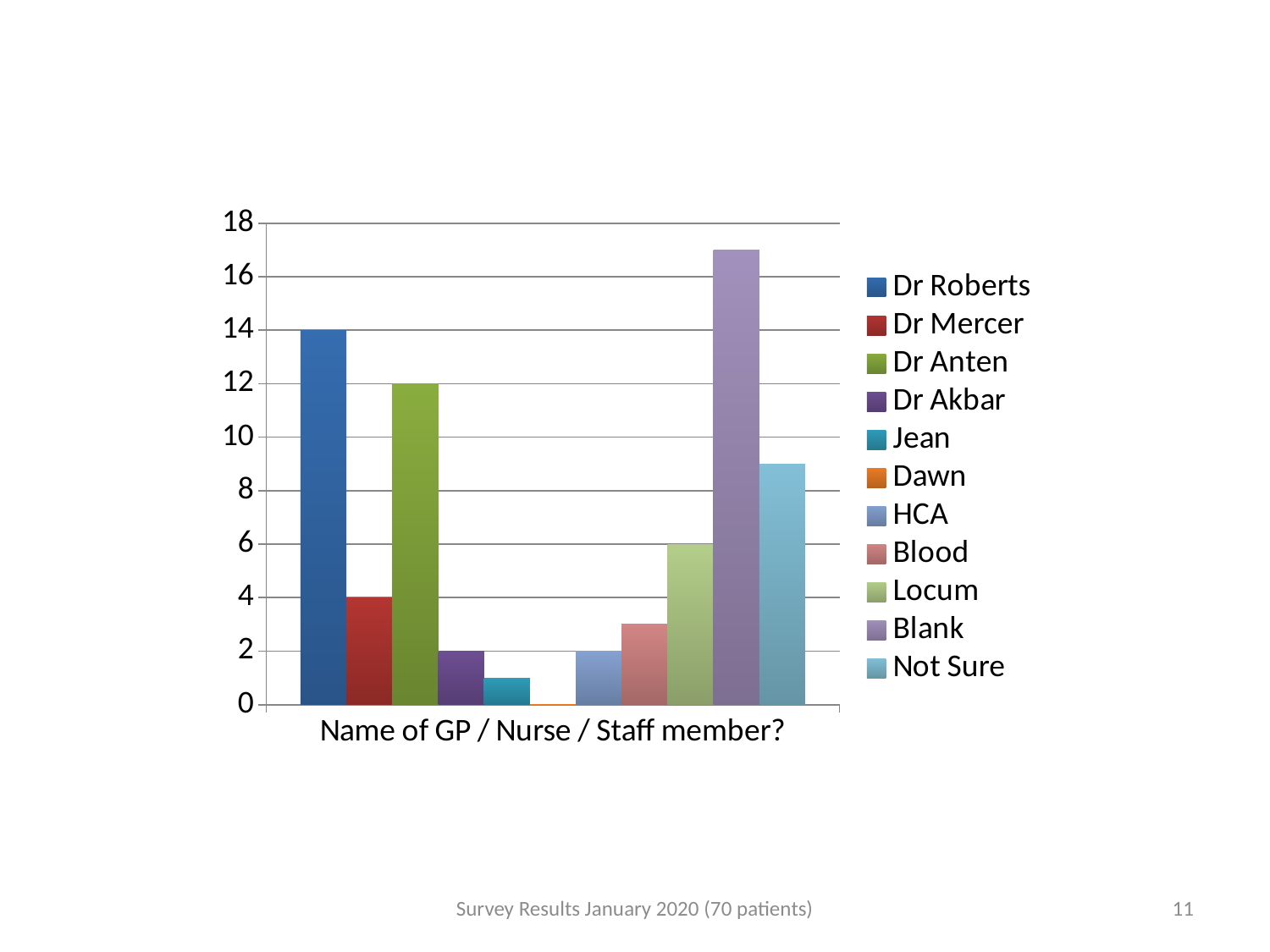
Which series has the lowest value? Dawn Is the value for Blank greater or less than 16? greater Which series has the highest value? Blank What kind of chart is shown on the slide? bar chart How many series does the legend list? 11 What is the label shown on the horizontal axis of the chart? Name of GP / Nurse / Staff member? What is the difference between the values for Dr Roberts and Dr Anten? 2 What is the value for Dr Mercer? 4 What is the value for Dr Roberts? 14 What is the value for Locum? 6 Which is larger, the value for Dr Anten or the value for Locum? Dr Anten What is the value for Dr Anten? 12